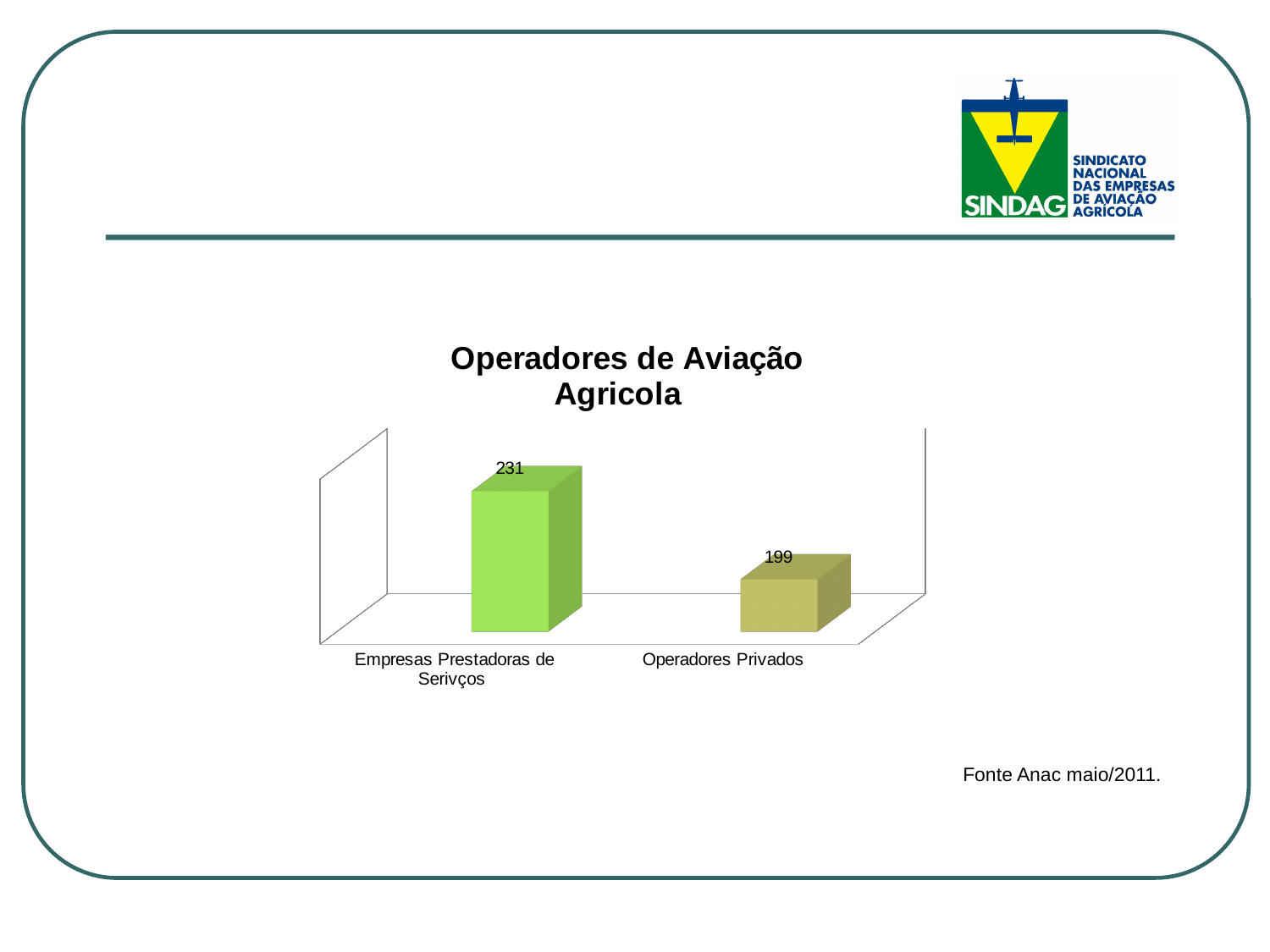
Which category has the lowest value? Operadores Privados What is the value for Operadores Privados? 199 What is the source cited below the chart? Fonte Anac maio/2011. How many categories are shown in the chart? 2 What kind of chart is shown on the slide? bar chart What is the title of the chart? Operadores de Aviação Agricola What is the value for Empresas Prestadoras de Serivços? 231 What is the total of the two values shown in the chart? 430 Which category has the highest value? Empresas Prestadoras de Serivços Which is larger, the value for Empresas Prestadoras de Serivços or the value for Operadores Privados? Empresas Prestadoras de Serivços What is the difference between the values for Empresas Prestadoras de Serivços and Operadores Privados? 32